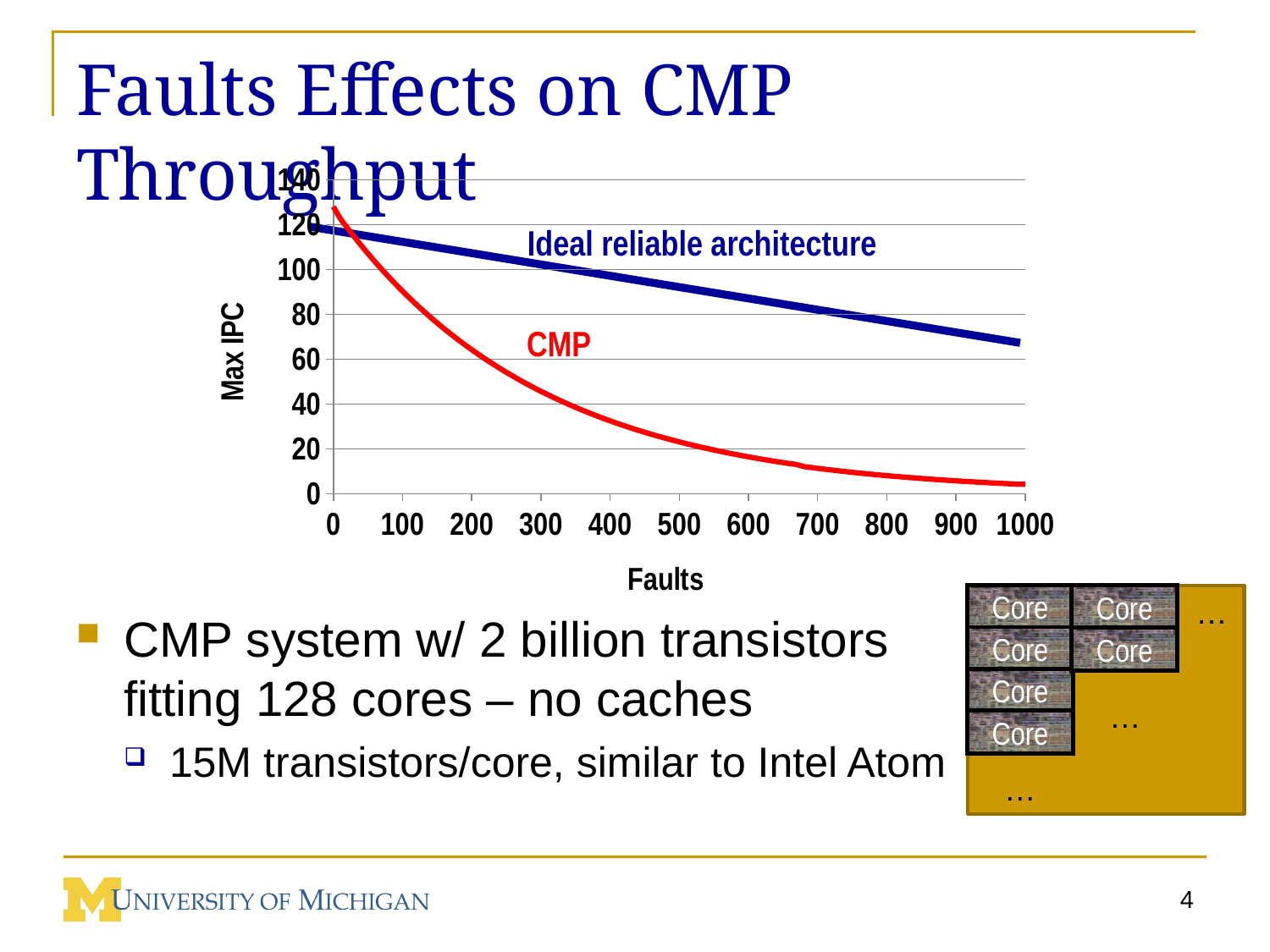
What are the names of the two series plotted on the chart? Ideal reliable architecture and CMP Is the Max IPC of the CMP series at 1000 faults greater or less than 20? less Is the Max IPC of the Ideal reliable architecture series at 1000 faults greater or less than 80? less What is the label of the x axis? Faults At 500 faults, which series has the higher Max IPC, CMP or Ideal reliable architecture? Ideal reliable architecture Is the Max IPC of the CMP series at 500 faults greater or less than 40? less Does the CMP series rise or fall as the number of faults increases? fall Does the Ideal reliable architecture series rise or fall as the number of faults increases? fall At 800 faults, which series has the lower Max IPC, CMP or Ideal reliable architecture? CMP What kind of chart is shown on the slide? line chart How many series are plotted on the chart? 2